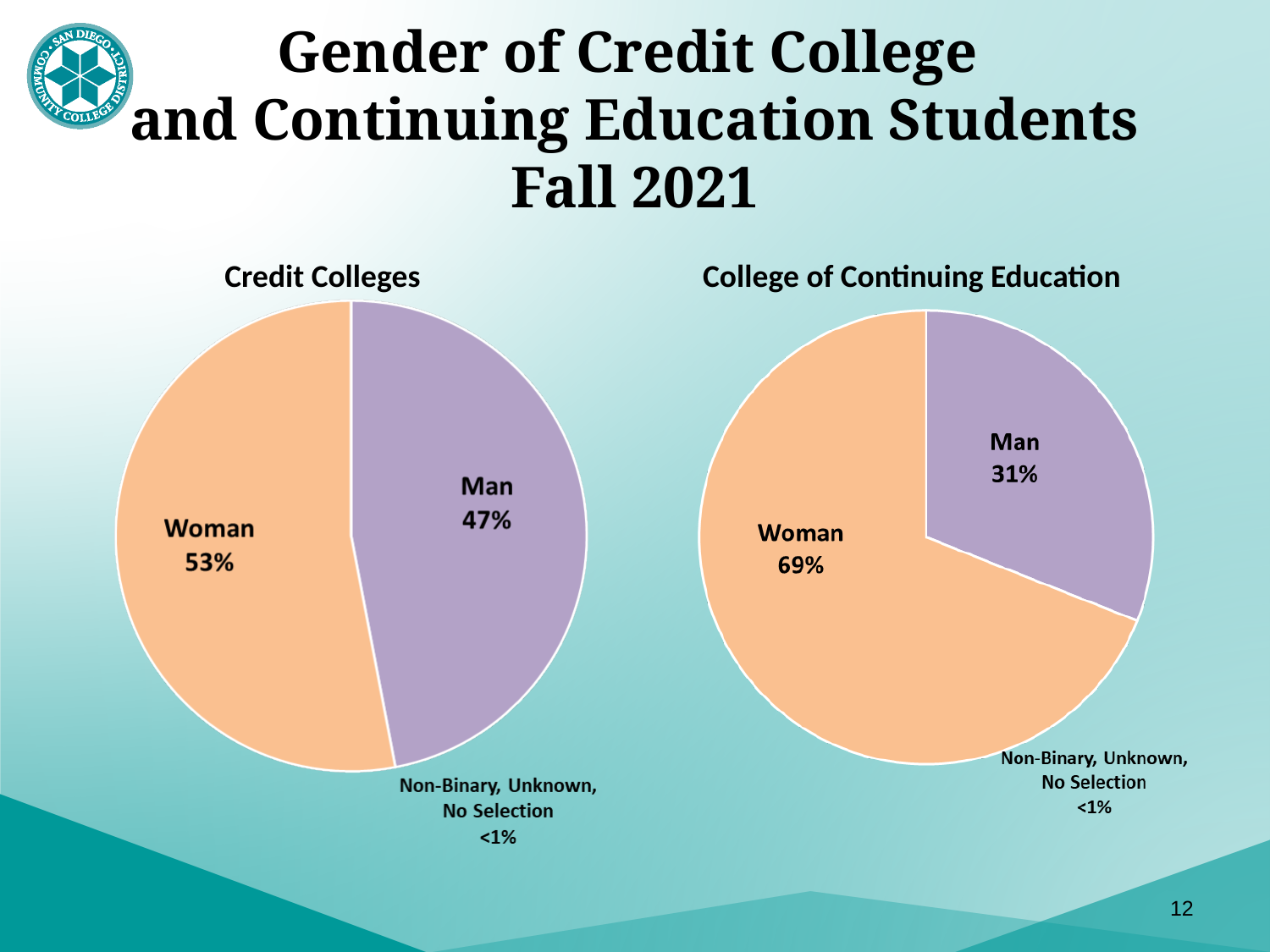
In the College of Continuing Education chart, what share of students are women? 69% In the College of Continuing Education chart, what share is labelled for Non-Binary, Unknown, No Selection? <1% In the College of Continuing Education chart, which category has the smallest slice? Non-Binary, Unknown, No Selection What type of chart is used on this slide? Pie chart In the Credit Colleges chart, what share of students are women? 53% In the Credit Colleges chart, what share of students are men? 47% How many categories are shown in the Credit Colleges chart? 3 In the College of Continuing Education chart, what share of students are men? 31% In the Credit Colleges chart, what is the difference between the Woman and Man shares? 6% In the College of Continuing Education chart, what is the difference between the Woman and Man shares? 38% In the Credit Colleges chart, which category has the largest slice? Woman Which chart has the larger share of women, Credit Colleges or College of Continuing Education? College of Continuing Education